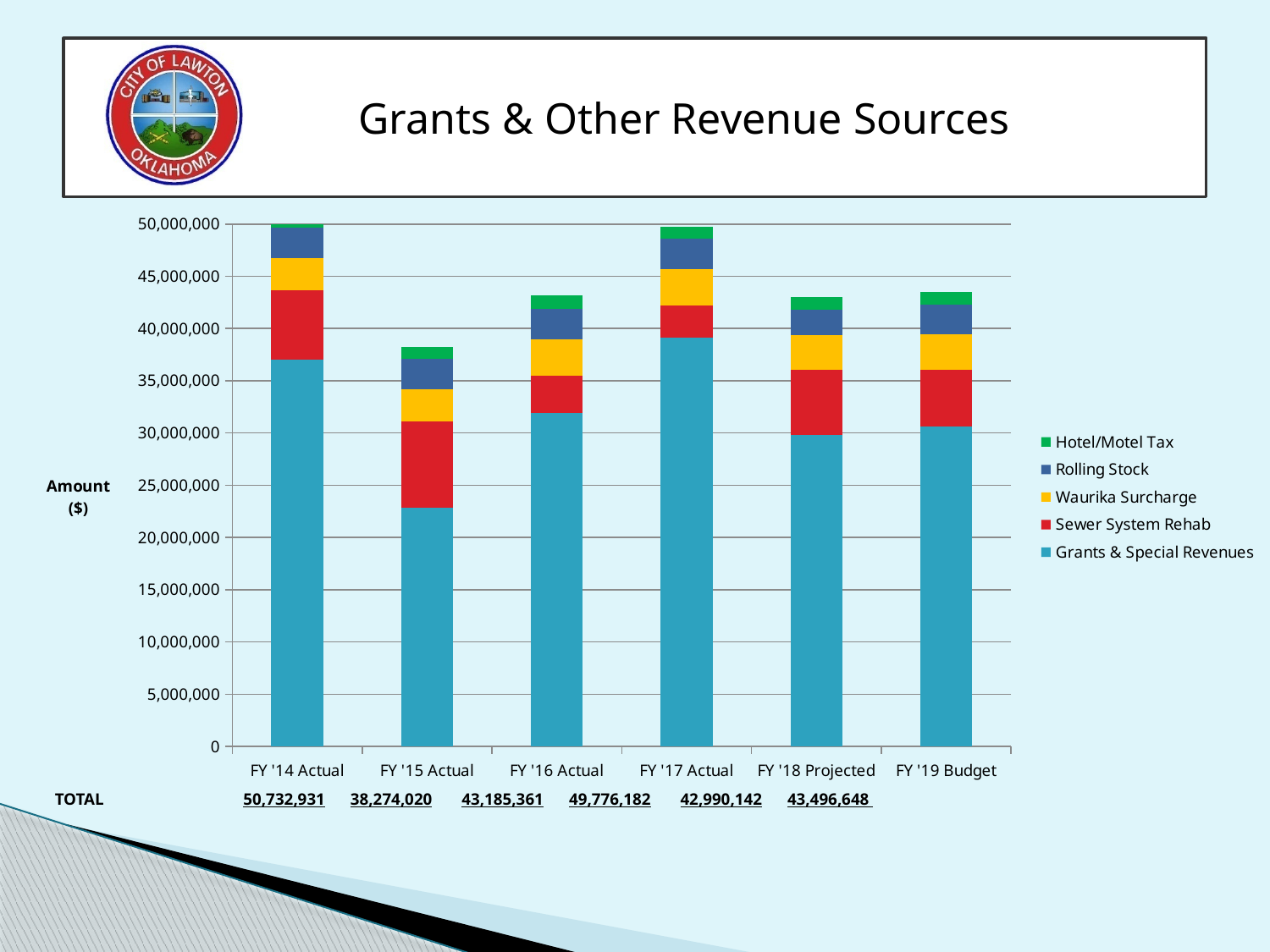
Which fiscal year has the highest total? FY '14 Actual What is the difference between the FY '14 Actual total and the FY '15 Actual total? 12,458,911 How many fiscal-year categories are plotted on the x axis? 6 Which total is larger, FY '19 Budget or FY '18 Projected? FY '19 Budget What is the title of the chart? Grants & Other Revenue Sources Which fiscal year has the lowest total? FY '15 Actual Is the Grants & Special Revenues value for FY '15 Actual greater or less than 25,000,000? less How many series does the legend list? 5 What is the difference between the FY '17 Actual total and the FY '16 Actual total? 6,590,821 What kind of chart is shown on the slide? Stacked bar chart What is the total shown for FY '14 Actual? 50,732,931 What is the total shown for FY '18 Projected? 42,990,142